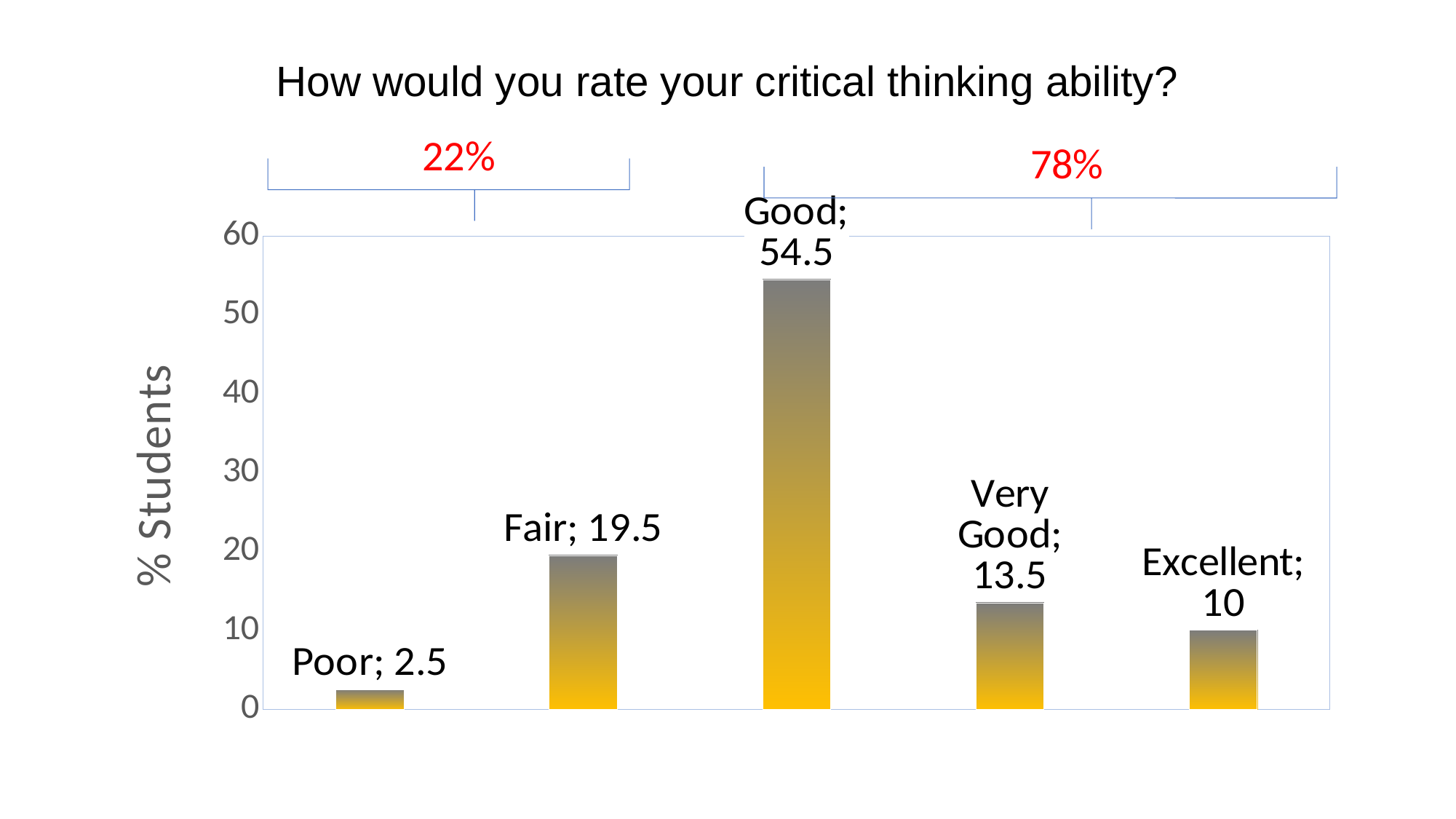
What is the title of the chart? How would you rate your critical thinking ability? What is the difference between the values for Good and Fair? 35 What is the difference between the values for Very Good and Excellent? 3.5 Which is larger, the value for Fair or the value for Very Good? Fair What percentage of students rated their critical thinking ability as Good? 54.5 How many categories are shown on the x axis? 5 Which category has the highest value? Good Which category has the lowest value? Poor What percentage is shown in red above the Good, Very Good and Excellent bars combined? 78% What is the value for the Fair category? 19.5 What kind of chart is shown on the slide? Bar chart What is the value for the Excellent category? 10